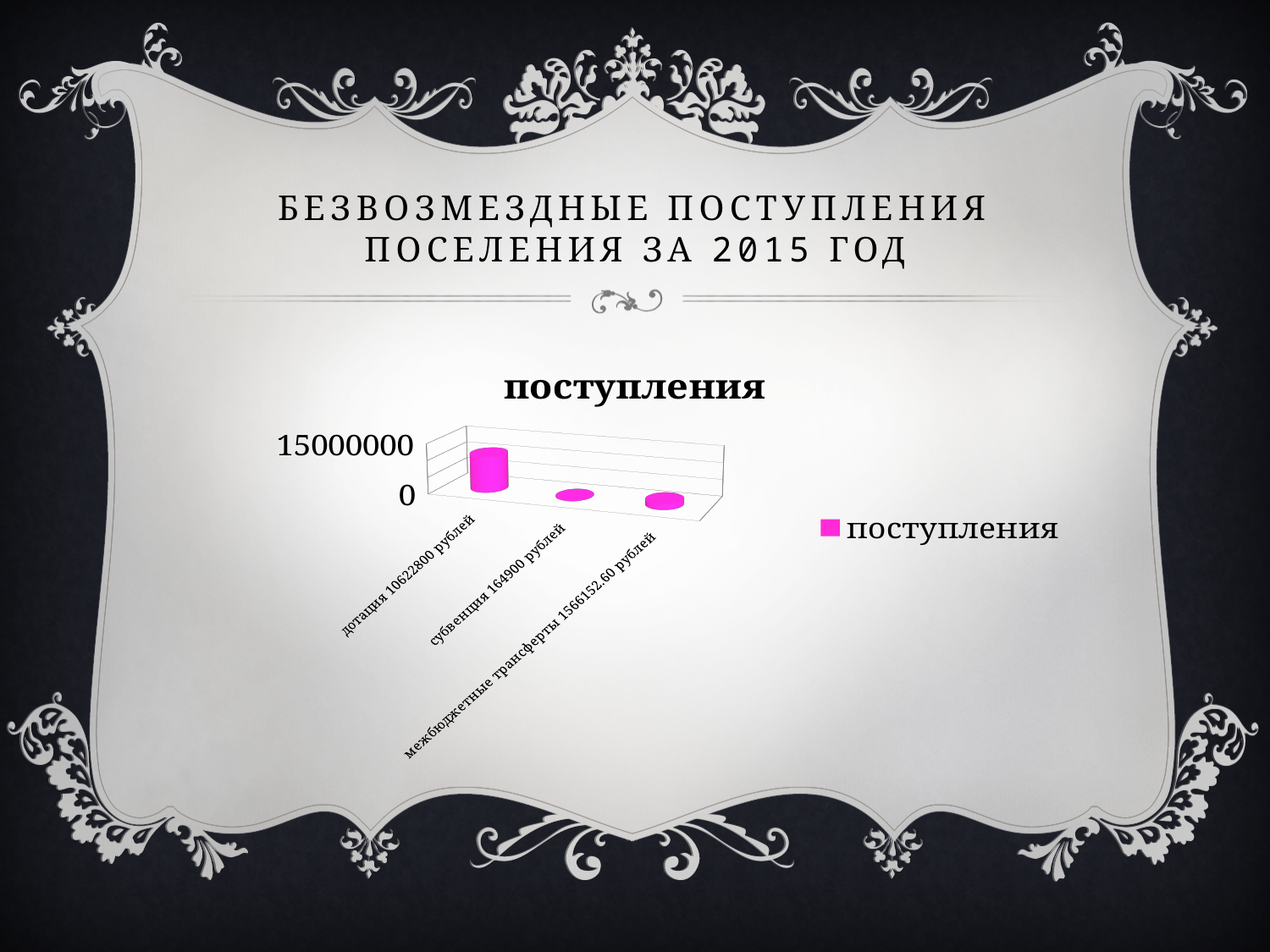
Which is larger, the value for дотация or the value for субвенции? дотация What colour are the bars in the chart? pink Which category has the lowest value in the chart? субвенция 164900 рублей How many categories are plotted in the chart? 3 What kind of chart is shown on the slide? bar chart Is the value for дотация greater or less than 15000000? less What is the title of the chart? поступления What value is printed in the category label for субвенции? 164900 рублей How many series does the legend list? 1 What value is printed in the category label for межбюджетные трансферты? 1566152.60 рублей Which category has the highest value in the chart? дотация 10622800 рублей What value is printed in the category label for дотация? 10622800 рублей